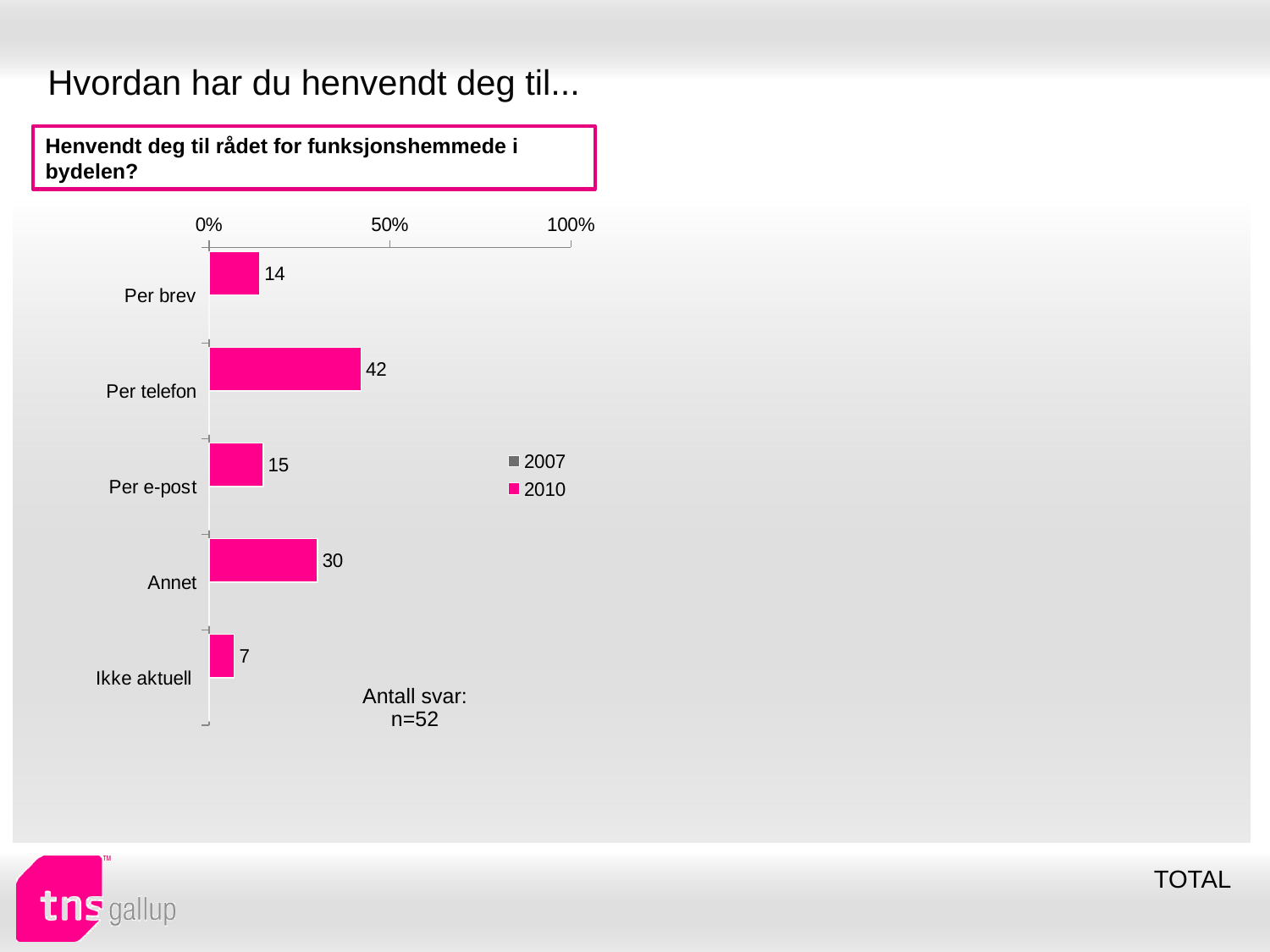
Is the 2010 value for Per telefon greater or less than 50%? less What is the 2010 value for Per telefon? 42 What is the difference between the 2010 values for Per telefon and Annet? 12 What is the 2010 value for Ikke aktuell? 7 What is the 2010 value for Per brev? 14 How many series does the legend list? 2 How many categories are shown on the chart? 5 What kind of chart is shown? bar chart What is the 2010 value for Annet? 30 Which has a larger 2010 value, Per e-post or Annet? Annet Which category has the lowest 2010 value? Ikke aktuell Which category has the highest 2010 value? Per telefon